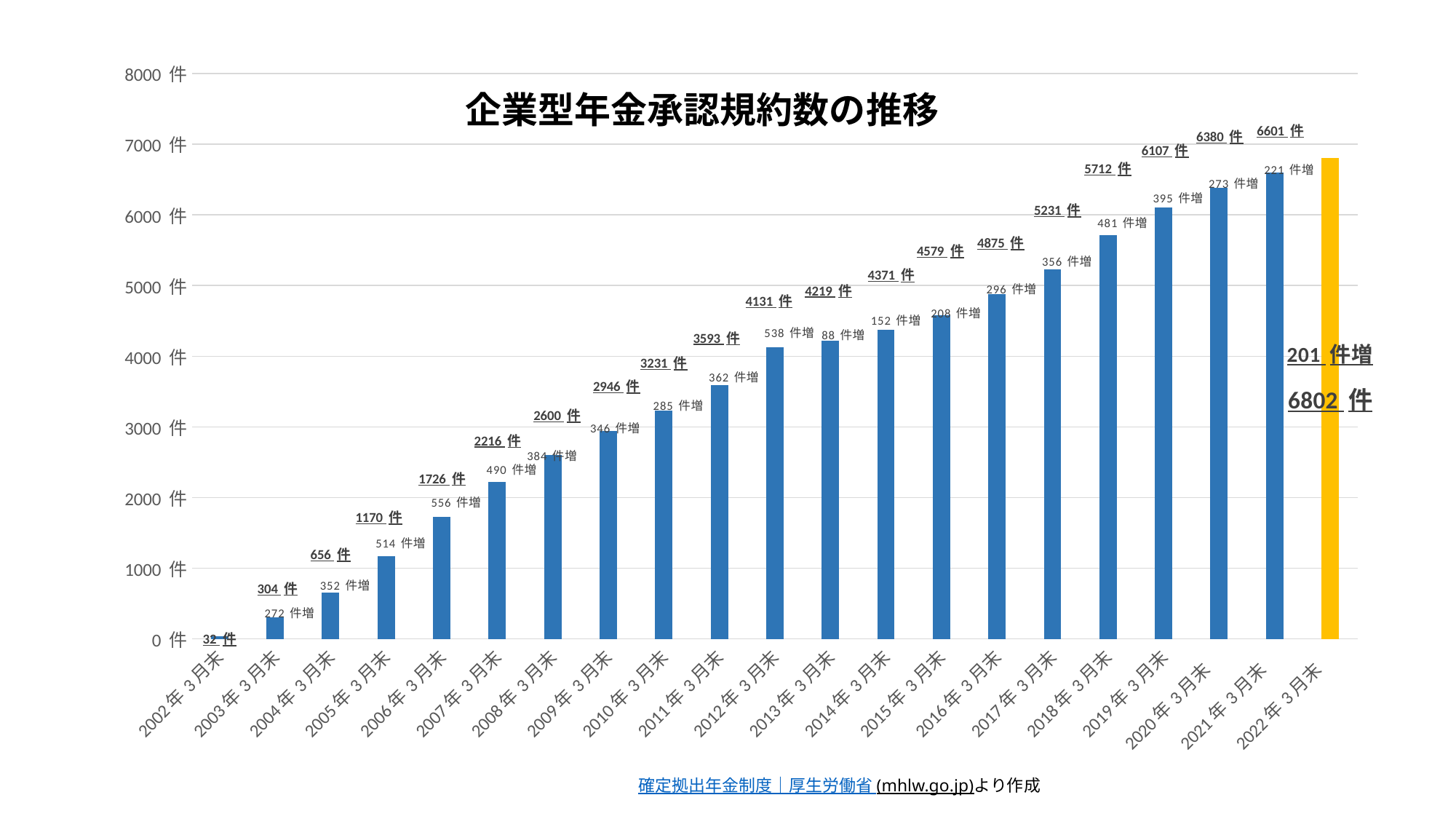
What is the value for 2022年3月末? 6802 件 Which year has the lowest value? 2002年3月末 What kind of chart is this? bar chart What is the difference between the values for 2007年3月末 and 2006年3月末? 490 件 What is the value for 2012年3月末? 4131 件 Do the values rise or fall from 2002年3月末 to 2022年3月末? rise Is the value for 2017年3月末 greater or less than 5000 件? greater Which is larger, the value for 2010年3月末 or the value for 2009年3月末? 2010年3月末 How many bars are shown in the chart? 21 What is the value for 2002年3月末? 32 件 What is the difference between the values for 2021年3月末 and 2020年3月末? 221 件 Which year has the highest value? 2022年3月末